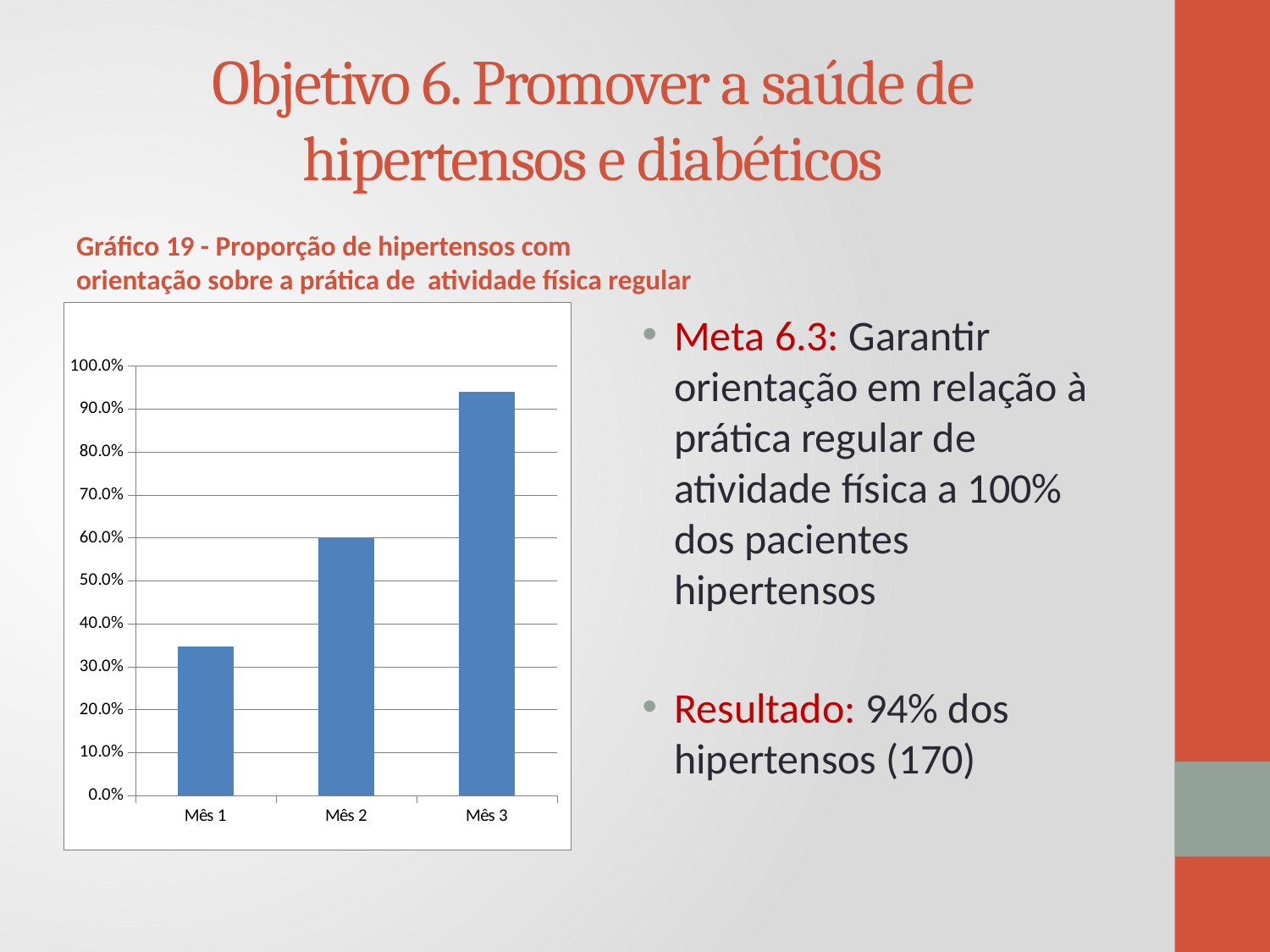
How many categories are shown on the x axis of the chart? 3 Which is larger, the value for Mês 2 or the value for Mês 1? Mês 2 Which month has the lowest value in the chart? Mês 1 Is the value for Mês 3 greater or less than 100.0%? less Is the value for Mês 3 greater or less than 90.0%? greater What is the highest value shown on the y axis of the chart? 100.0% Which month has the highest value in the chart? Mês 3 Do the values rise or fall from Mês 1 to Mês 3? rise What kind of chart is shown on the slide? bar chart What is the title of the chart on the slide? Gráfico 19 - Proporção de hipertensos com orientação sobre a prática de atividade física regular Is the value for Mês 1 greater or less than 30.0%? greater